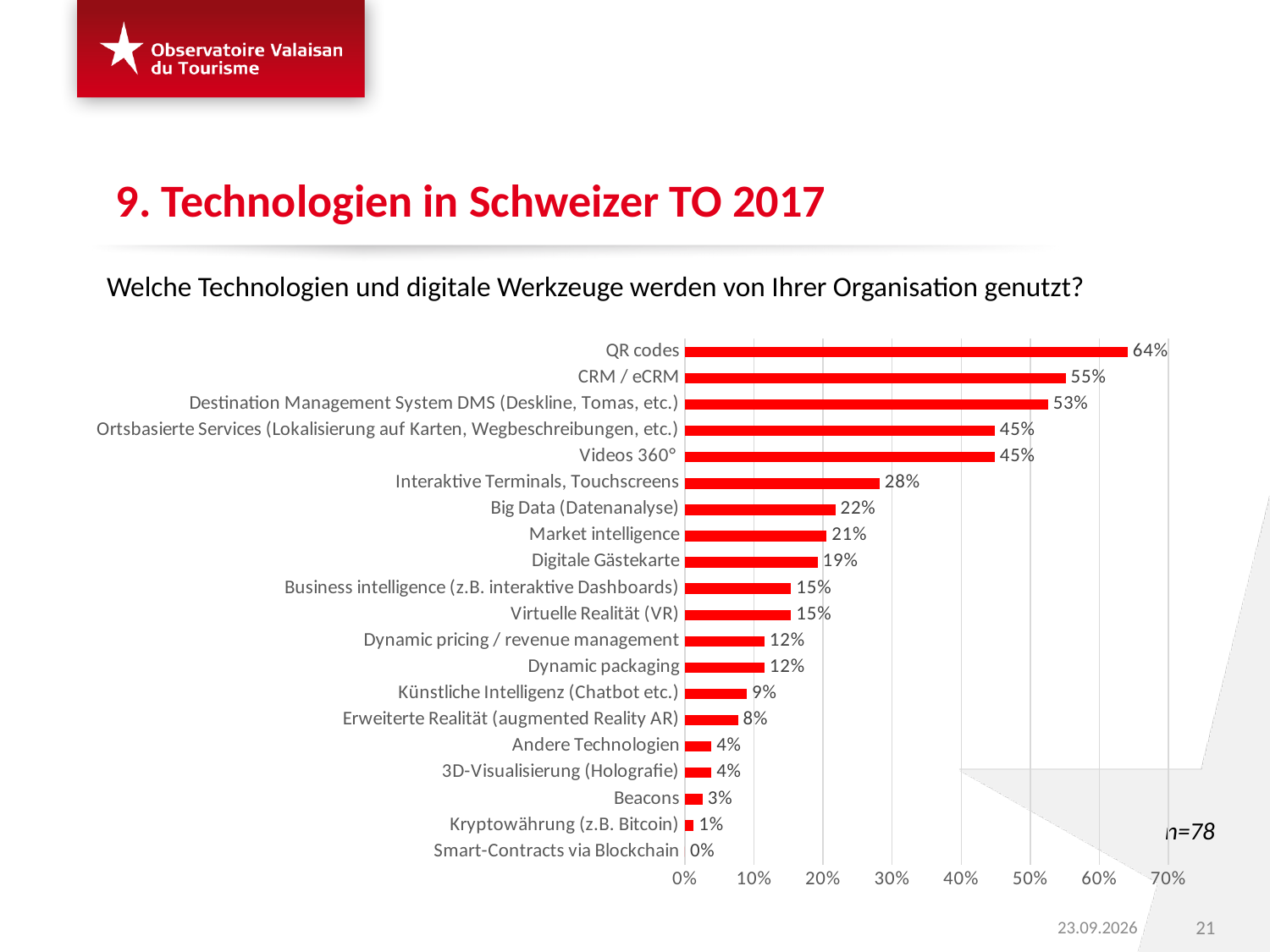
What is the sample size (n) stated on the slide? n=78 What is the difference between Interaktive Terminals, Touchscreens and Digitale Gästekarte? 9% What is the difference between the values for QR codes and CRM / eCRM? 9% What type of chart is shown on the slide? Bar chart Which technology has the highest usage share? QR codes How many technology categories are shown in the chart? 20 What is the value for Big Data (Datenanalyse)? 22% Which is larger, the value for Market intelligence or the value for Virtuelle Realität (VR)? Market intelligence What percentage of organisations use QR codes? 64% Which technology has the lowest usage share? Smart-Contracts via Blockchain What is the value for CRM / eCRM? 55% What is the value for Beacons? 3%